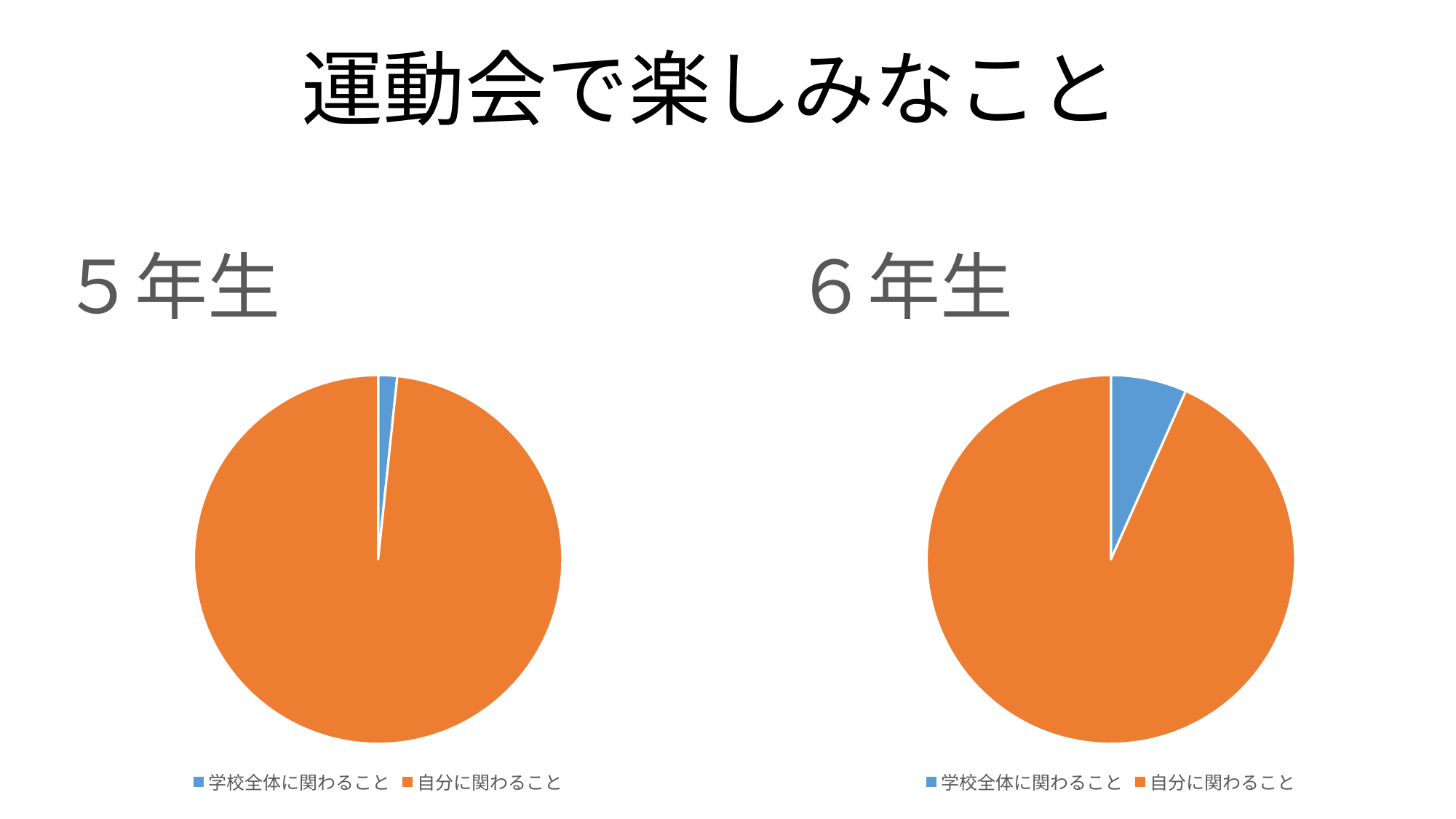
What is the title at the top of the slide? 運動会で楽しみなこと How many entries does the legend of the 5年生 pie chart list? 2 In the 5年生 pie chart, which category has the largest slice? 自分に関わること In the 6年生 pie chart, how many slices are there? 2 In the 6年生 pie chart, what colour is the slice for 学校全体に関わること? blue In the 6年生 pie chart, which category has the smallest slice? 学校全体に関わること In the 5年生 pie chart, how many slices are there? 2 What kind of chart is shown under the heading 5年生? pie chart Which pie chart has the larger slice for 学校全体に関わること, 5年生 or 6年生? 6年生 In the 5年生 pie chart, which category has the smallest slice? 学校全体に関わること In the 6年生 pie chart, which category has the largest slice? 自分に関わること What kind of chart is shown under the heading 6年生? pie chart